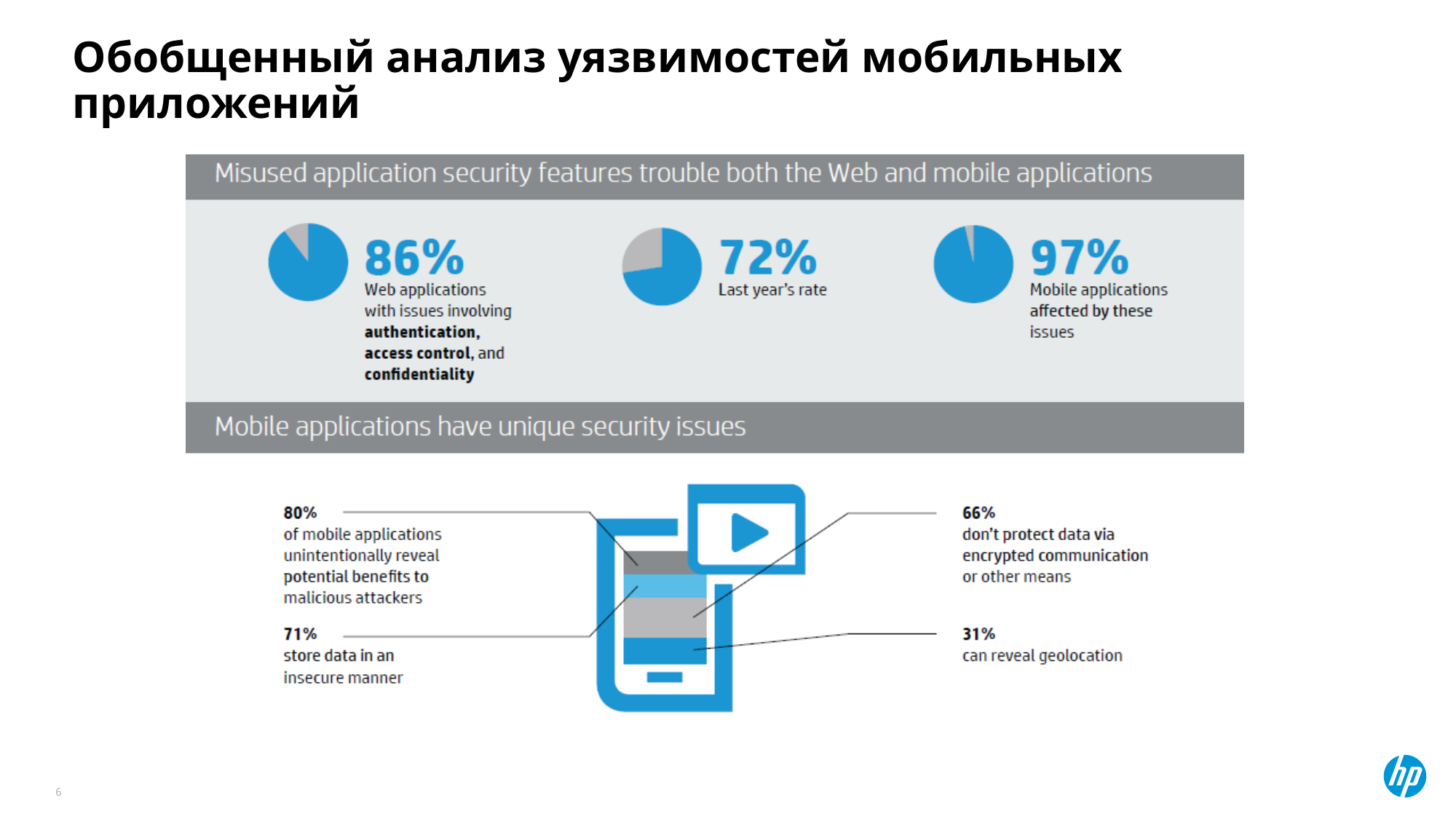
In the bottom infographic, what is the difference between the share that don't protect data via encrypted communication (66%) and the share that can reveal geolocation (31%)? 35 percentage points In the top infographic, what was last year's rate for Web applications with these issues? 72% In the top infographic, which is larger: the share of Web applications with these issues or the share of mobile applications affected by these issues? Mobile applications (97%) In the bottom infographic, which statistic has the lowest percentage? Can reveal geolocation (31%) In the top infographic, what kind of charts are used to show the 86%, 72% and 97% values? Pie charts In the top infographic, which of the three pie charts shows the highest percentage? Mobile applications affected by these issues (97%) In the bottom infographic, what percentage of mobile applications unintentionally reveal potential benefits to malicious attackers? 80% How many pie charts are shown in the top infographic? 3 In the top infographic, what percentage of Web applications have issues involving authentication, access control, and confidentiality? 86% In the top infographic, by how many percentage points did the Web application rate rise from last year's 72% to the current 86%? 14 In the bottom infographic, what percentage of mobile applications store data in an insecure manner? 71% In the top infographic, what percentage of mobile applications are affected by these issues? 97%